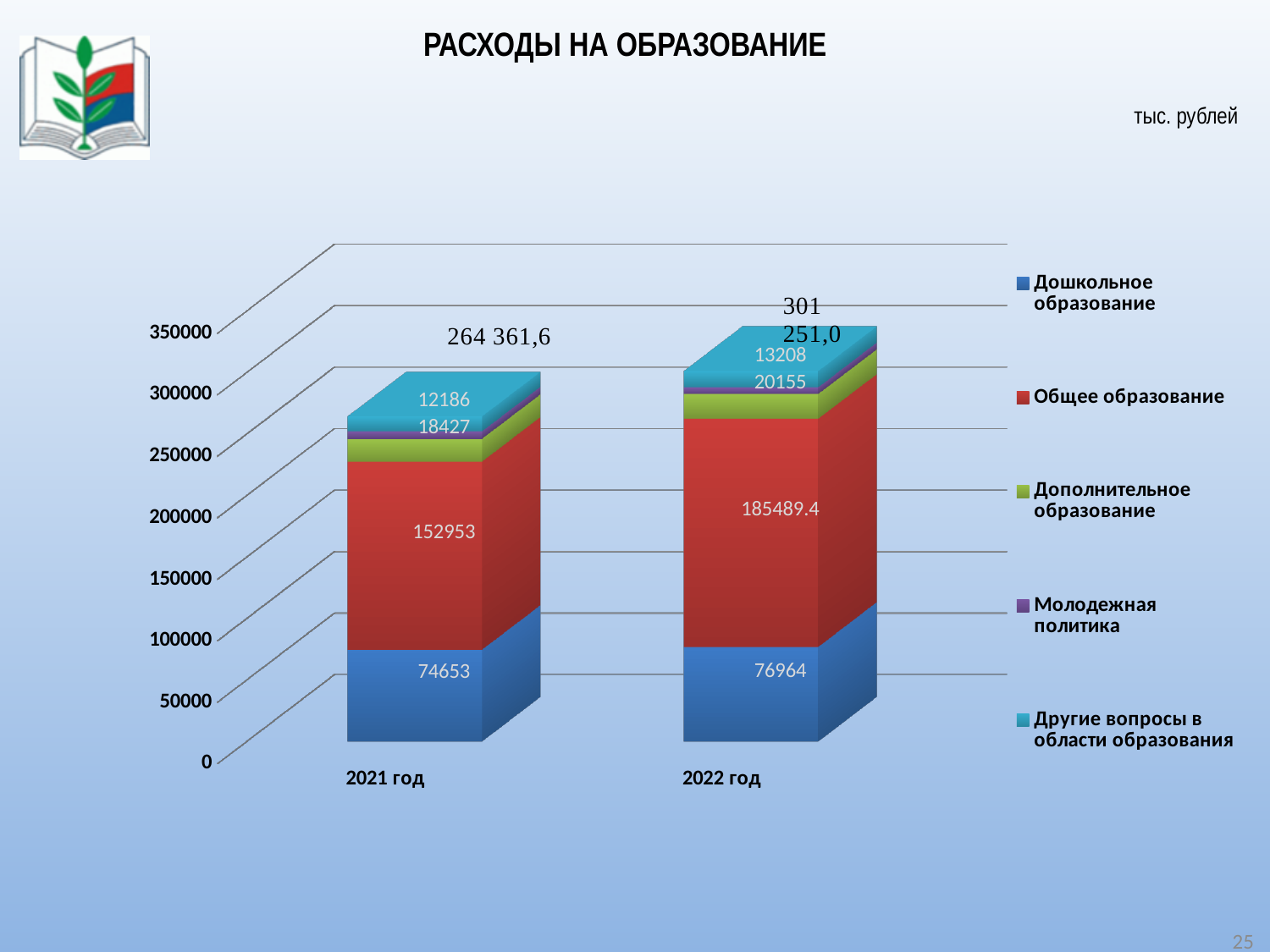
Which year has the larger value for Общее образование, 2021 год or 2022 год? 2022 год Is the total of the 2022 год bar greater or less than 300000? greater What is the value for Дополнительное образование in 2021 год? 18427 What total is printed above the 2021 год bar? 264 361,6 What kind of chart is shown on the slide? stacked bar chart What is the value for Дошкольное образование in 2022 год? 76964 What is the difference between the Дошкольное образование values for 2022 год and 2021 год? 2311 How many categories (years) are shown on the x axis? 2 What is the value for Другие вопросы в области образования in 2022 год? 13208 How many series does the legend list? 5 What is the value for Общее образование in 2021 год? 152953 What is the value for Общее образование in 2022 год? 185489.4